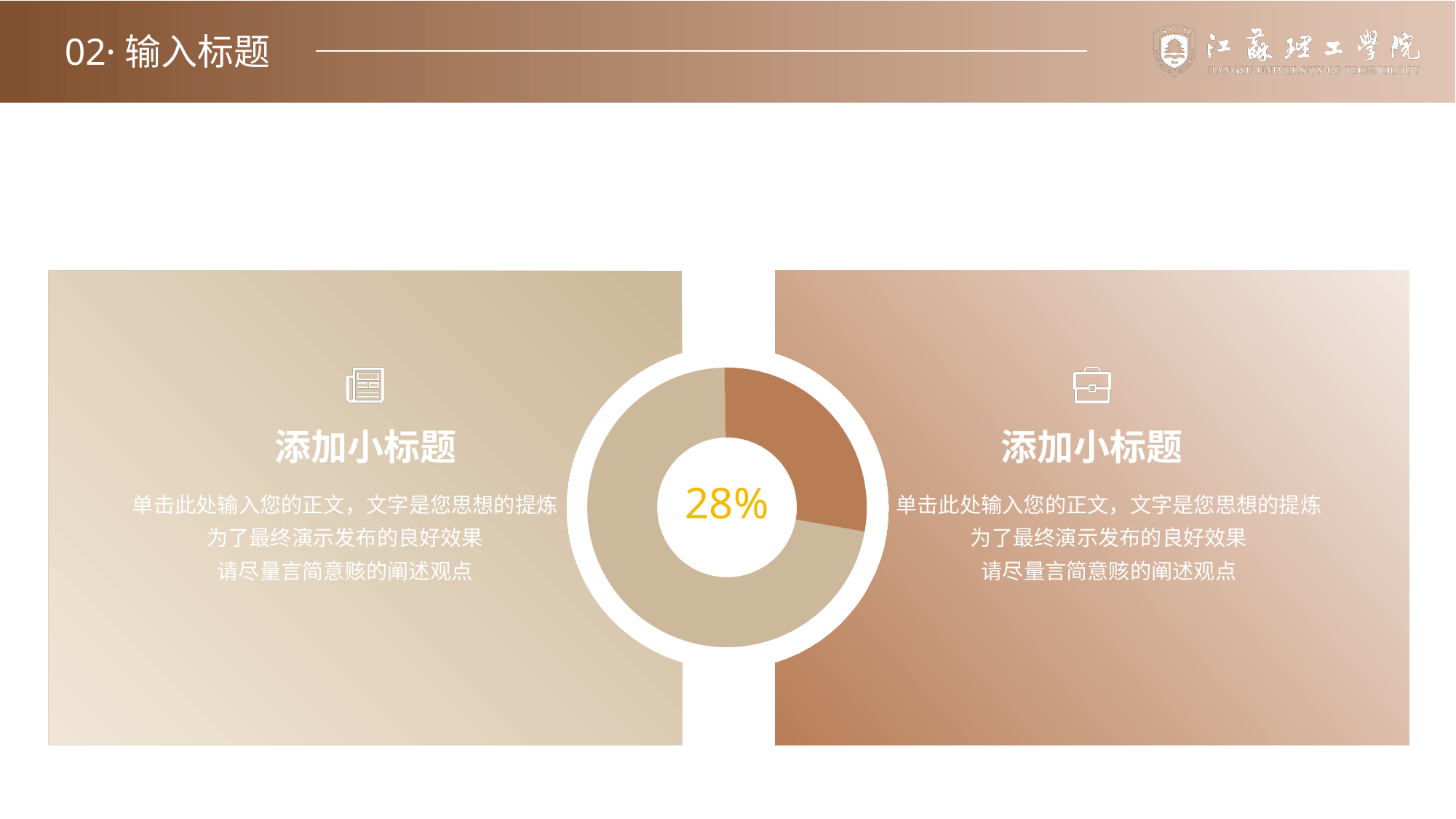
Does the doughnut chart have a legend? No Which slice of the doughnut chart is larger, the darker brown slice or the lighter beige slice? The lighter beige slice Is the darker brown slice of the doughnut chart greater or less than 50% of the whole? less How many slices does the doughnut chart have? 2 What colour is the percentage text in the centre of the doughnut chart? Yellow/gold What value is printed in the centre of the doughnut chart? 28% What kind of chart is shown in the centre of the slide? Doughnut (pie) chart What share of the doughnut chart does the darker brown slice represent? 28% Is the lighter beige slice of the doughnut chart greater or less than 50% of the whole? greater